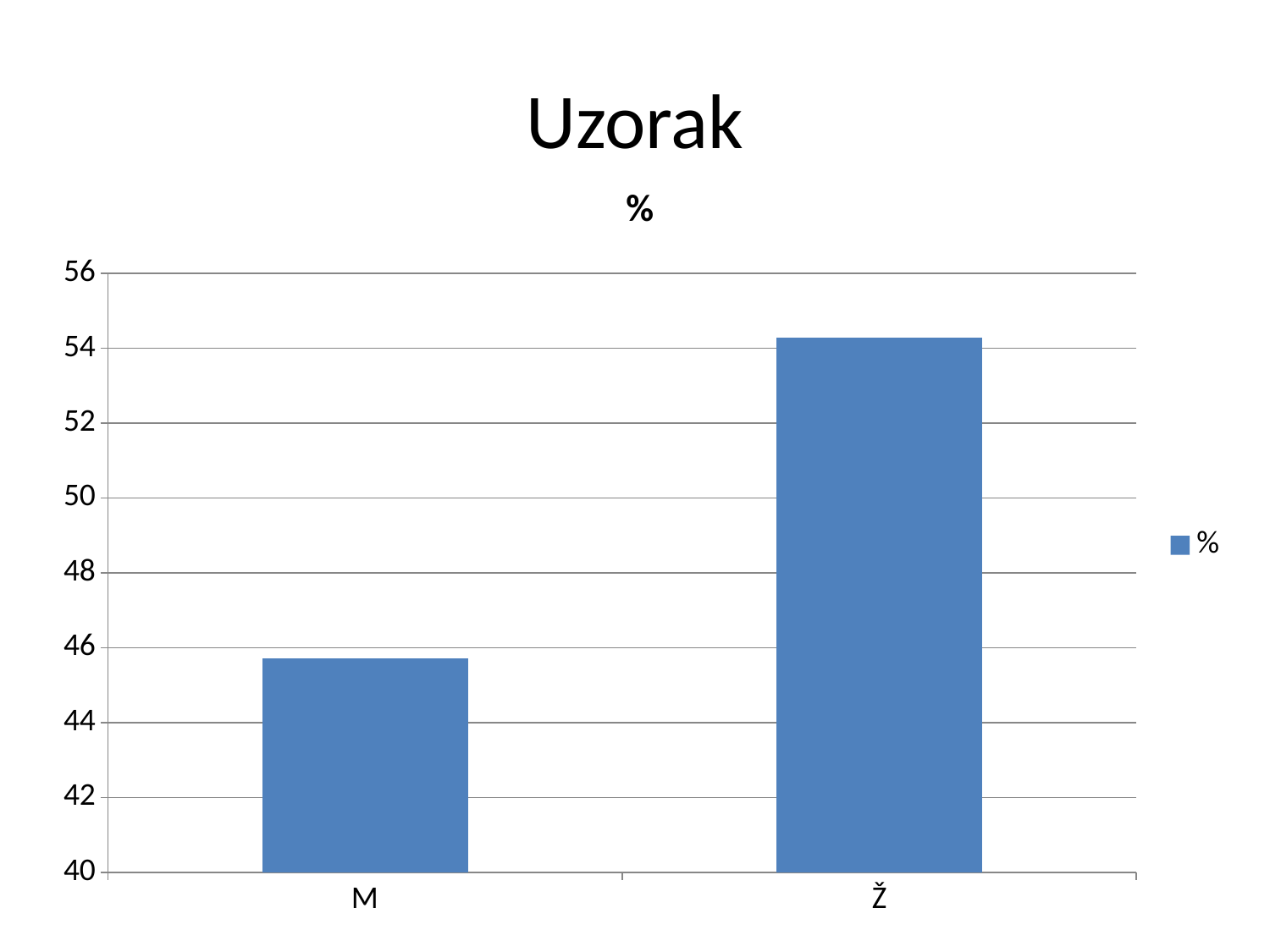
Is the value for Ž greater or less than 54? greater Is the value for M greater or less than 46? less How many series does the legend list? 1 What is the title of the chart? % What kind of chart is shown on the slide? bar chart Which category has the highest value? Ž Which category has the lowest value? M Is the value for Ž greater or less than 56? less How many categories are shown on the x axis? 2 Which is larger, the value for M or the value for Ž? Ž What is the name of the series listed in the legend? %